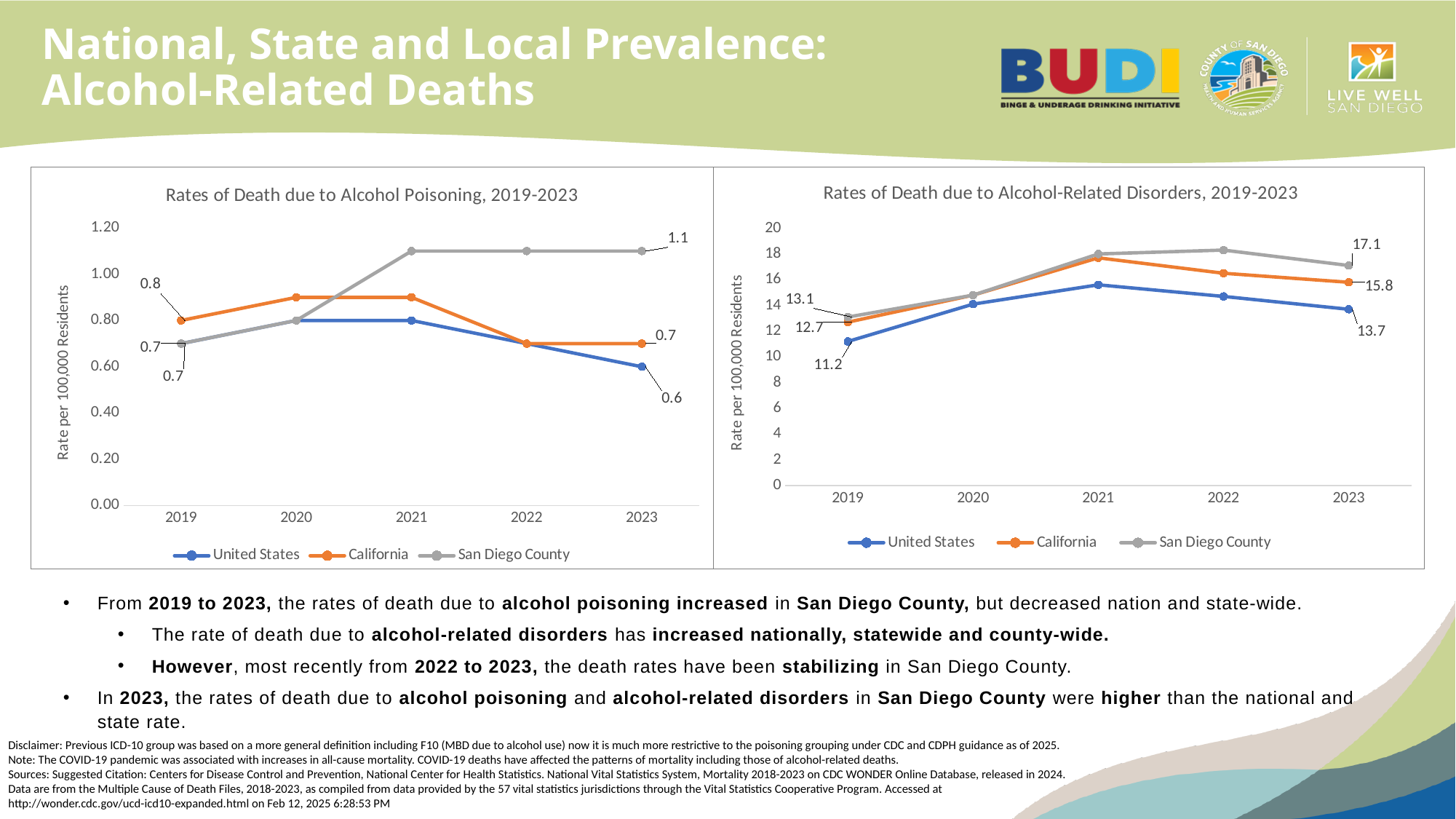
In the 'Rates of Death due to Alcohol Poisoning, 2019-2023' chart, what is the rate for the United States in 2023? 0.6 What kind of chart is the 'Rates of Death due to Alcohol Poisoning, 2019-2023' chart? line chart In the 'Rates of Death due to Alcohol-Related Disorders, 2019-2023' chart, what is the rate for the United States in 2019? 11.2 In the 'Rates of Death due to Alcohol Poisoning, 2019-2023' chart, which is larger in 2019, the California rate or the United States rate? California How many series does the legend of the 'Rates of Death due to Alcohol-Related Disorders, 2019-2023' chart list? 3 In the 'Rates of Death due to Alcohol-Related Disorders, 2019-2023' chart, what is the rate for San Diego County in 2023? 17.1 In the 'Rates of Death due to Alcohol-Related Disorders, 2019-2023' chart, is the United States rate in 2021 greater or less than 14? greater In the 'Rates of Death due to Alcohol Poisoning, 2019-2023' chart, what is the difference between the San Diego County and United States rates in 2023? 0.5 In the 'Rates of Death due to Alcohol-Related Disorders, 2019-2023' chart, which series has the highest rate in 2023? San Diego County In the 'Rates of Death due to Alcohol Poisoning, 2019-2023' chart, what is the rate for California in 2019? 0.8 In the 'Rates of Death due to Alcohol-Related Disorders, 2019-2023' chart, what is the difference between the San Diego County and California rates in 2023? 1.3 In the 'Rates of Death due to Alcohol Poisoning, 2019-2023' chart, what is the rate for San Diego County in 2023? 1.1